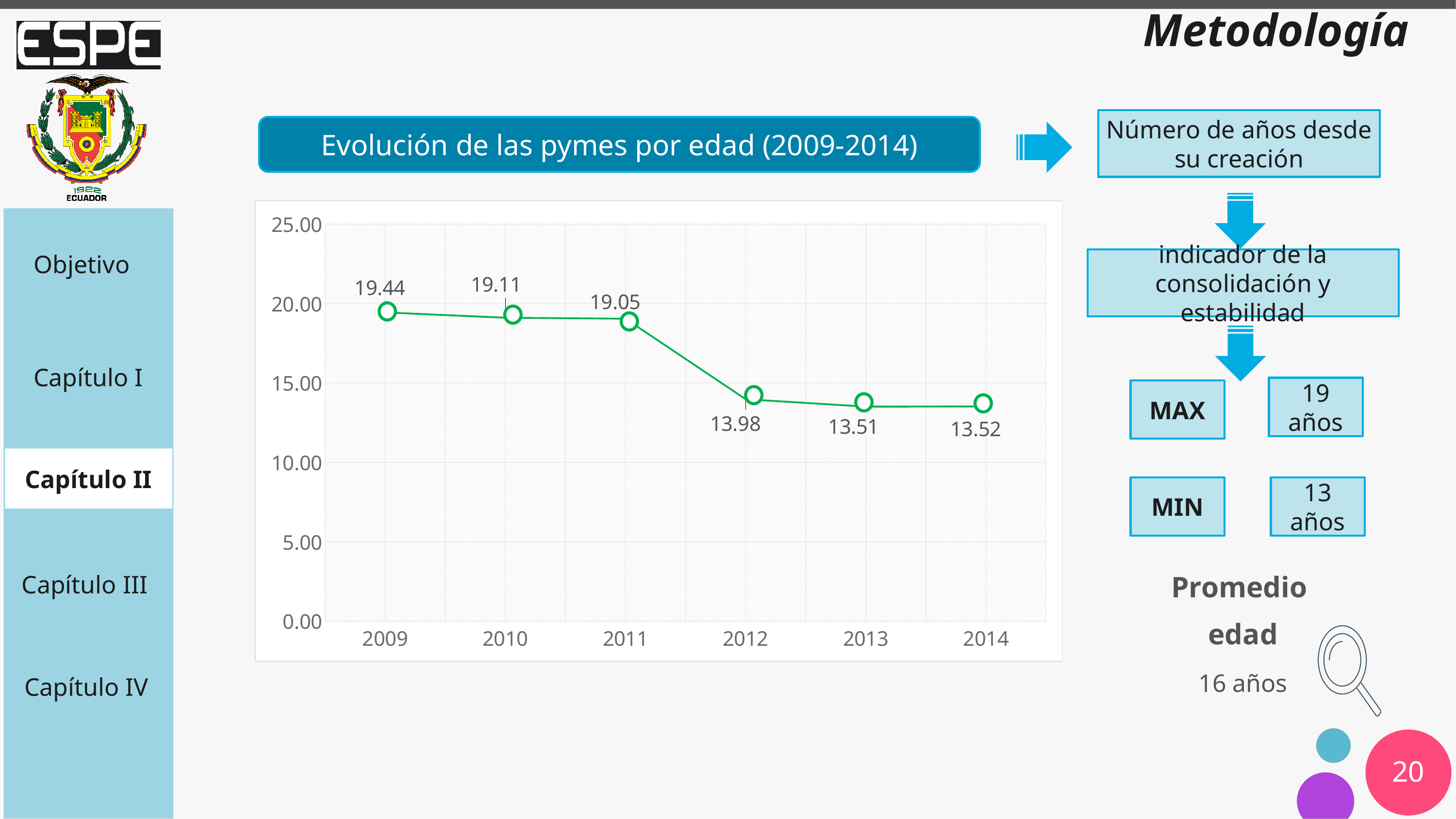
Which is larger, the value for 2010 or the value for 2013? 2010 What is the value for 2009? 19.44 Which year has the highest value? 2009 What is the value for 2012? 13.98 What type of chart is shown on the slide? Line chart Which year has the lowest value? 2013 Do the values generally rise or fall from 2009 to 2014? Fall What is the value for 2014? 13.52 What is the difference between the values for 2011 and 2012? 5.07 How many years are plotted on the x axis? 6 Is the value for 2011 greater or less than 15.00? greater What is the title shown above the chart? Evolución de las pymes por edad (2009-2014)